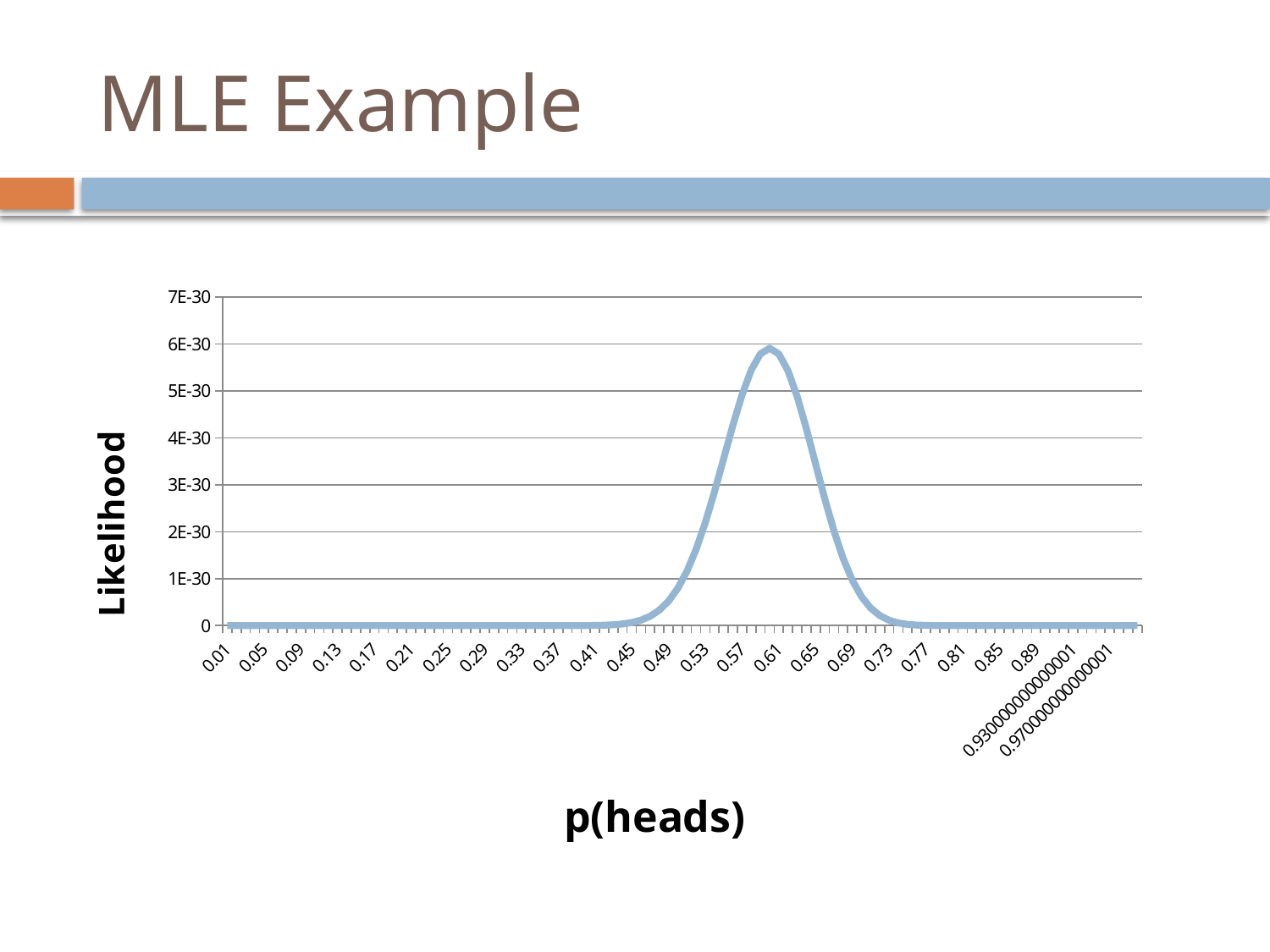
What is the title of the vertical axis? Likelihood What kind of chart is shown on the slide? line chart Does the likelihood rise or fall as p(heads) goes from 0.61 to 0.77? fall Is the likelihood at p(heads) = 0.45 greater or less than 1E-30? less Is the likelihood at p(heads) = 0.61 greater or less than 5E-30? greater What is the title of the horizontal axis? p(heads) Does the likelihood rise or fall as p(heads) goes from 0.45 to 0.61? rise At which value of p(heads) does the likelihood reach its highest point? 0.61 Is the likelihood at p(heads) = 0.65 greater or less than 3E-30? greater Which has the larger likelihood, p(heads) = 0.53 or p(heads) = 0.61? 0.61